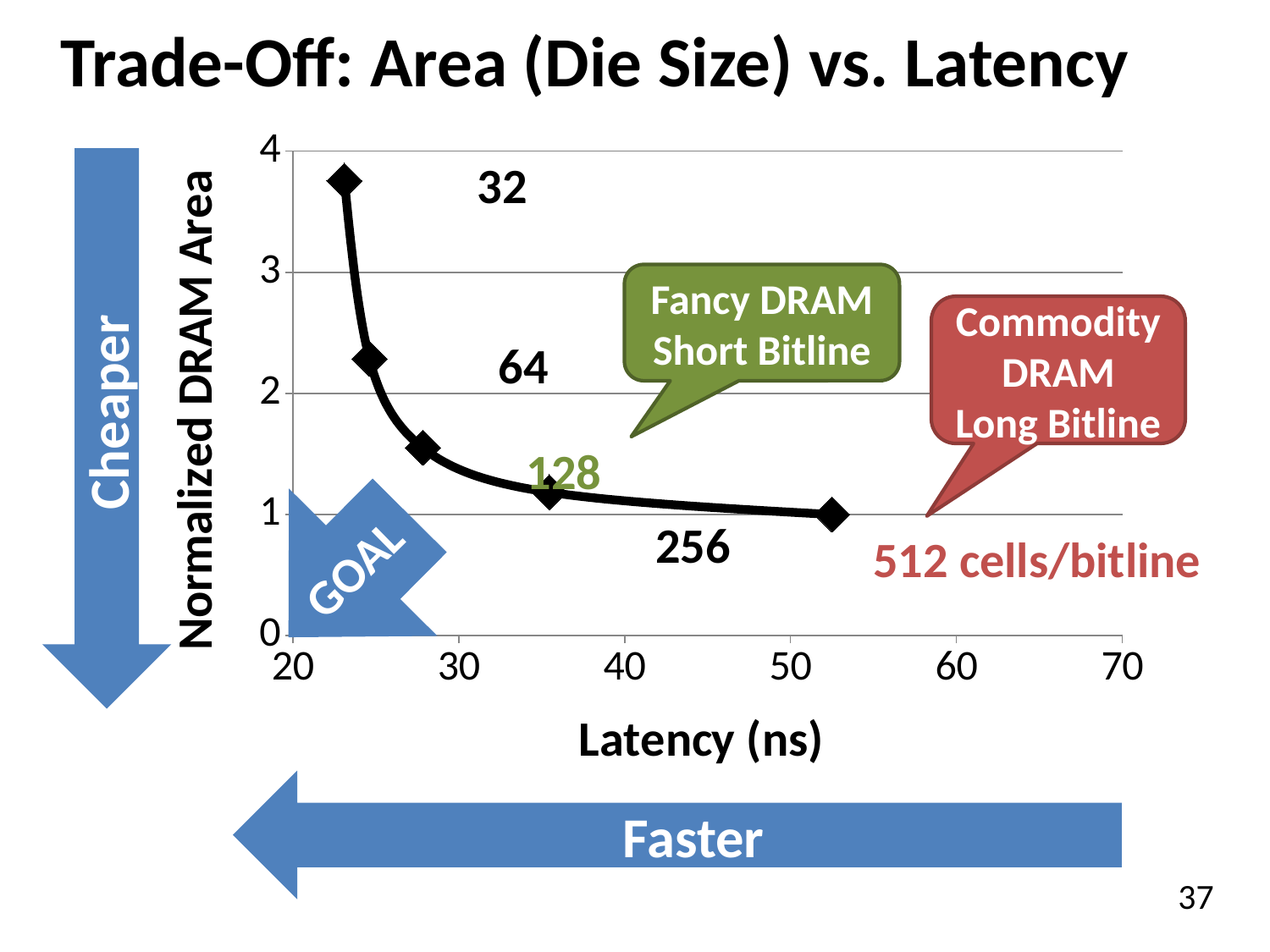
Which labeled point has the highest normalized DRAM area? 32 What is the title of the chart's x axis? Latency (ns) Is the normalized DRAM area for the point labeled 128 greater or less than 2? less Is the latency for the point labeled 256 greater or less than 30 ns? greater What kind of chart is shown on the slide? line chart Which has a larger normalized DRAM area, the point labeled 64 or the point labeled 256? 64 What is the title of the chart's y axis? Normalized DRAM Area Is the normalized DRAM area for the point labeled 32 greater or less than 3? greater Which labeled point has the lowest normalized DRAM area? 512 cells/bitline As latency increases along the x axis, does the normalized DRAM area rise or fall? fall How many data points are plotted on the chart? 5